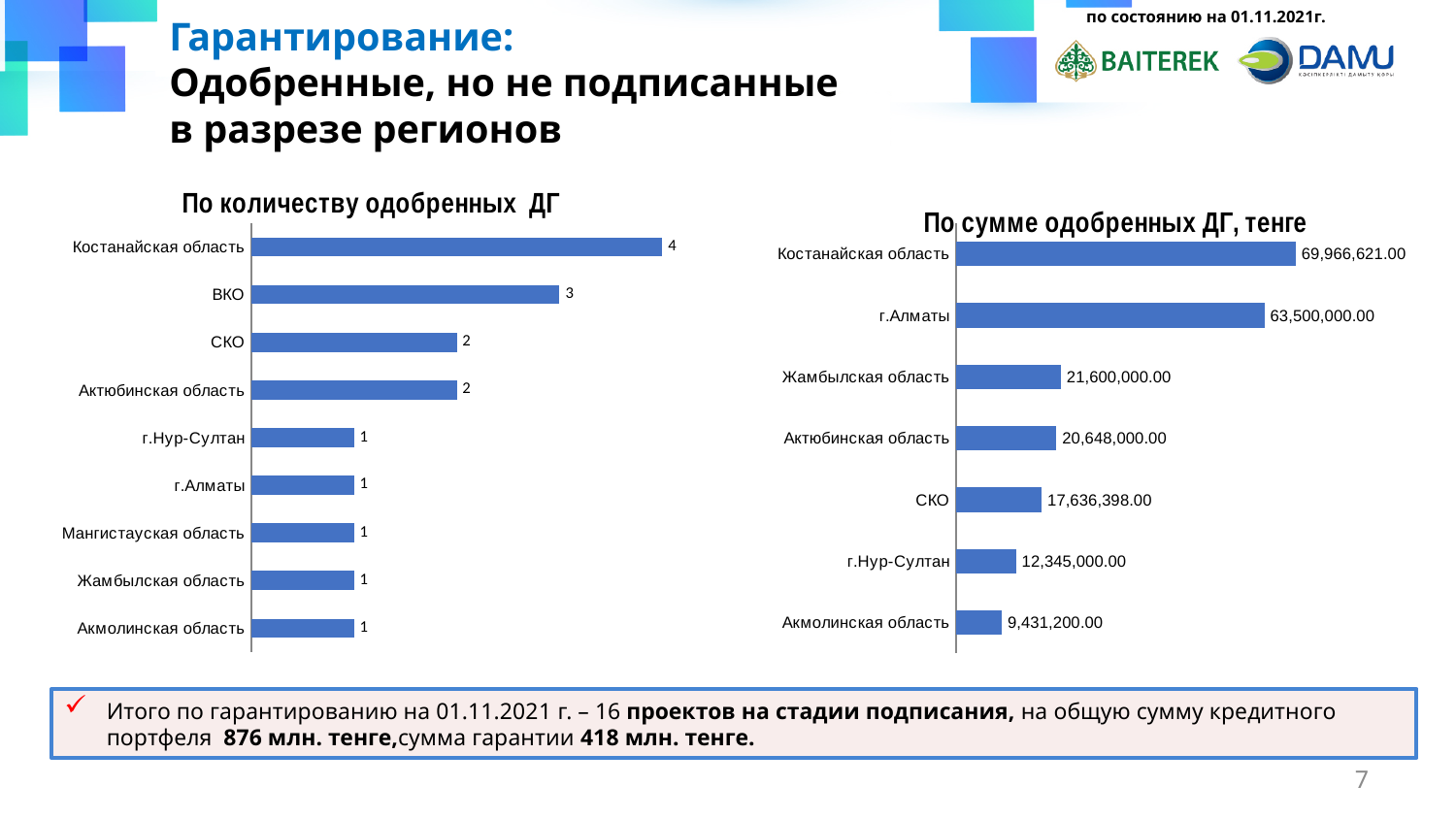
In the chart 'По сумме одобренных ДГ, тенге', which region has the lowest value? Акмолинская область What type of chart is 'По сумме одобренных ДГ, тенге'? Bar chart In the chart 'По количеству одобренных ДГ', how many regions are shown? 9 In the chart 'По количеству одобренных ДГ', what is the value for Костанайская область? 4 In the chart 'По количеству одобренных ДГ', what is the value for ВКО? 3 In the chart 'По сумме одобренных ДГ, тенге', how many regions are shown? 7 In the chart 'По количеству одобренных ДГ', which region has the highest value? Костанайская область In the chart 'По сумме одобренных ДГ, тенге', which is larger: Актюбинская область or СКО? Актюбинская область In the chart 'По сумме одобренных ДГ, тенге', what is the difference between Костанайская область and г.Алматы? 6,466,621.00 In the chart 'По сумме одобренных ДГ, тенге', what is the value for г.Алматы? 63,500,000.00 In the chart 'По сумме одобренных ДГ, тенге', what is the value for Жамбылская область? 21,600,000.00 In the chart 'По количеству одобренных ДГ', what is the difference between Костанайская область and СКО? 2